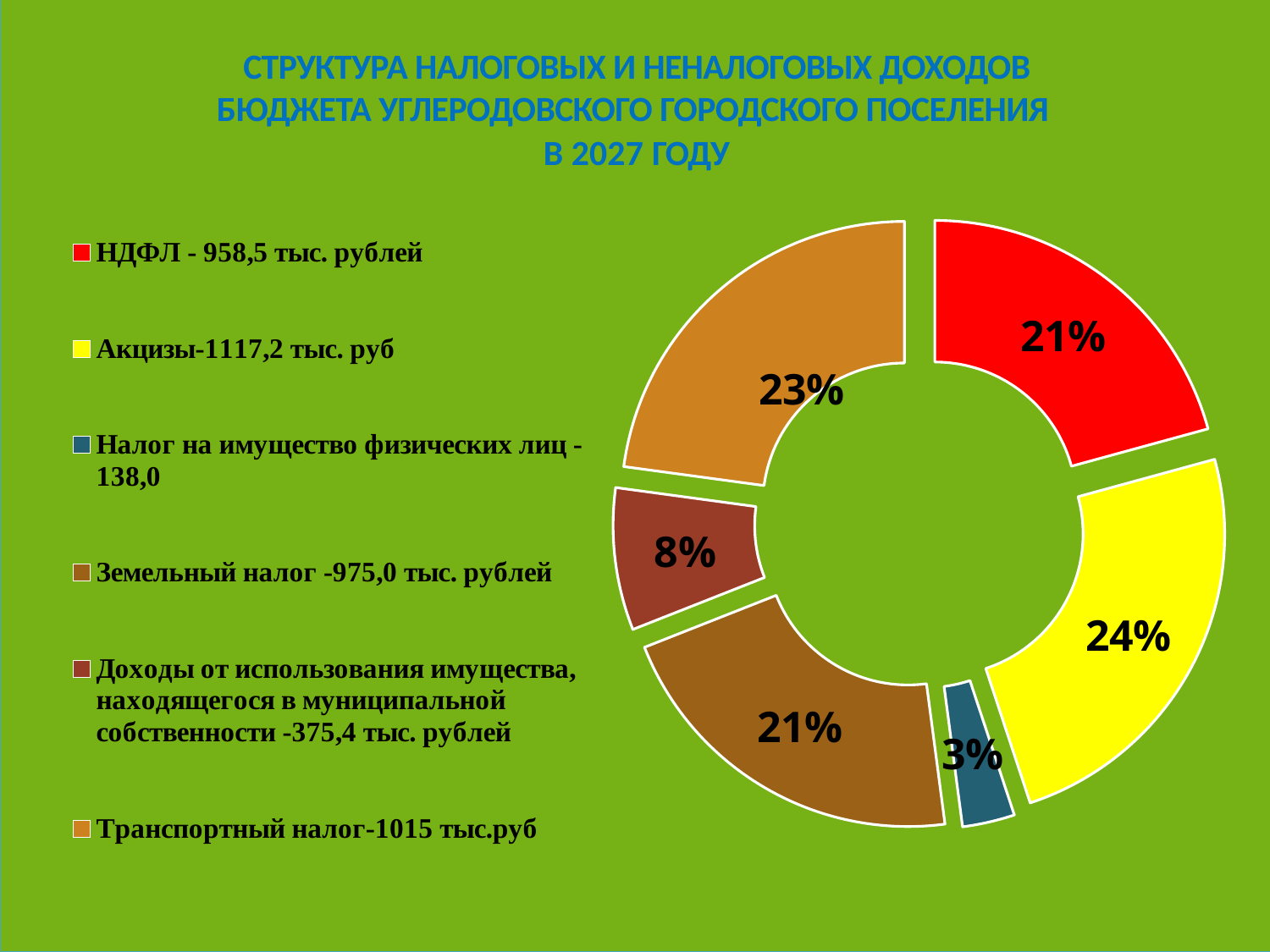
How many slices does the chart have? 6 What is the difference in percentage points between the Акцизы slice and the Доходы от использования имущества slice? 16 What value in thousands of rubles does the legend give for Земельный налог? 975,0 тыс. рублей What percentage is shown for Налог на имущество физических лиц? 3% What share of the chart does the red slice (НДФЛ) represent? 21% What percentage is shown for Транспортный налог? 23% Which category has the largest share of the chart? Акцизы What percentage is shown for Доходы от использования имущества, находящегося в муниципальной собственности? 8% What percentage is shown for the yellow slice (Акцизы)? 24% What kind of chart is shown on the slide? Doughnut (pie) chart Which category has the smallest share of the chart? Налог на имущество физических лиц Which is larger: the share for Транспортный налог or the share for Земельный налог? Транспортный налог